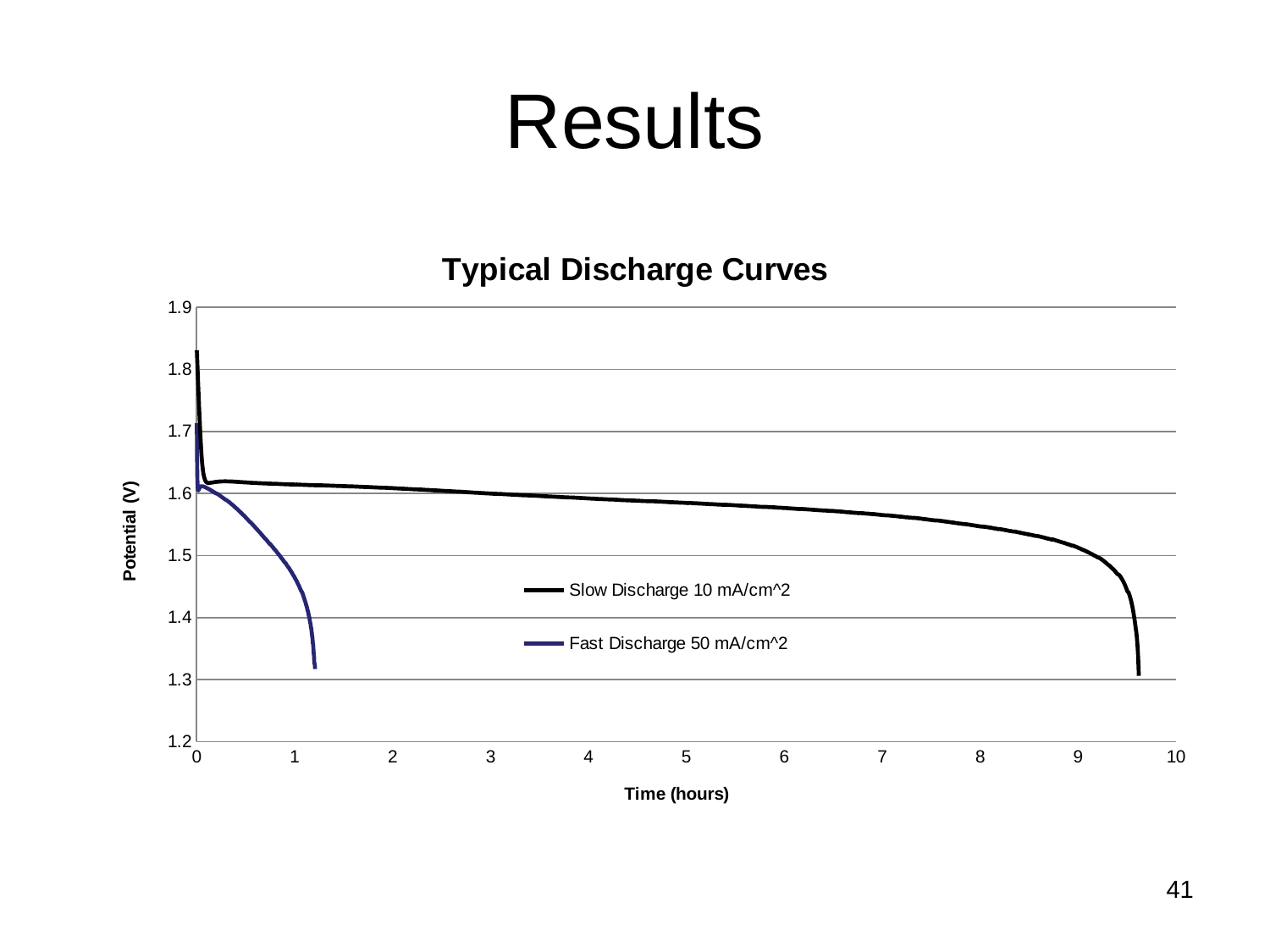
What kind of chart is shown on the slide? Line chart Is the potential of the Fast Discharge 50 mA/cm^2 curve at 0.5 hours greater or less than 1.5 V? greater Does the Fast Discharge 50 mA/cm^2 curve rise or fall as time increases from 0.2 to 1.2 hours? Fall Does the Slow Discharge 10 mA/cm^2 curve rise or fall as time increases from 1 to 9 hours? Fall Is the potential of the Slow Discharge 10 mA/cm^2 curve at 5 hours greater or less than 1.5 V? greater How many series does the legend list? 2 Is the potential of the Fast Discharge 50 mA/cm^2 curve at 1 hour greater or less than 1.6 V? less Which series reaches a later time on the x axis before its potential drops sharply? Slow Discharge 10 mA/cm^2 What is the title of the chart? Typical Discharge Curves What is the label of the vertical axis? Potential (V) At 1 hour, which series has the higher potential, Slow Discharge 10 mA/cm^2 or Fast Discharge 50 mA/cm^2? Slow Discharge 10 mA/cm^2